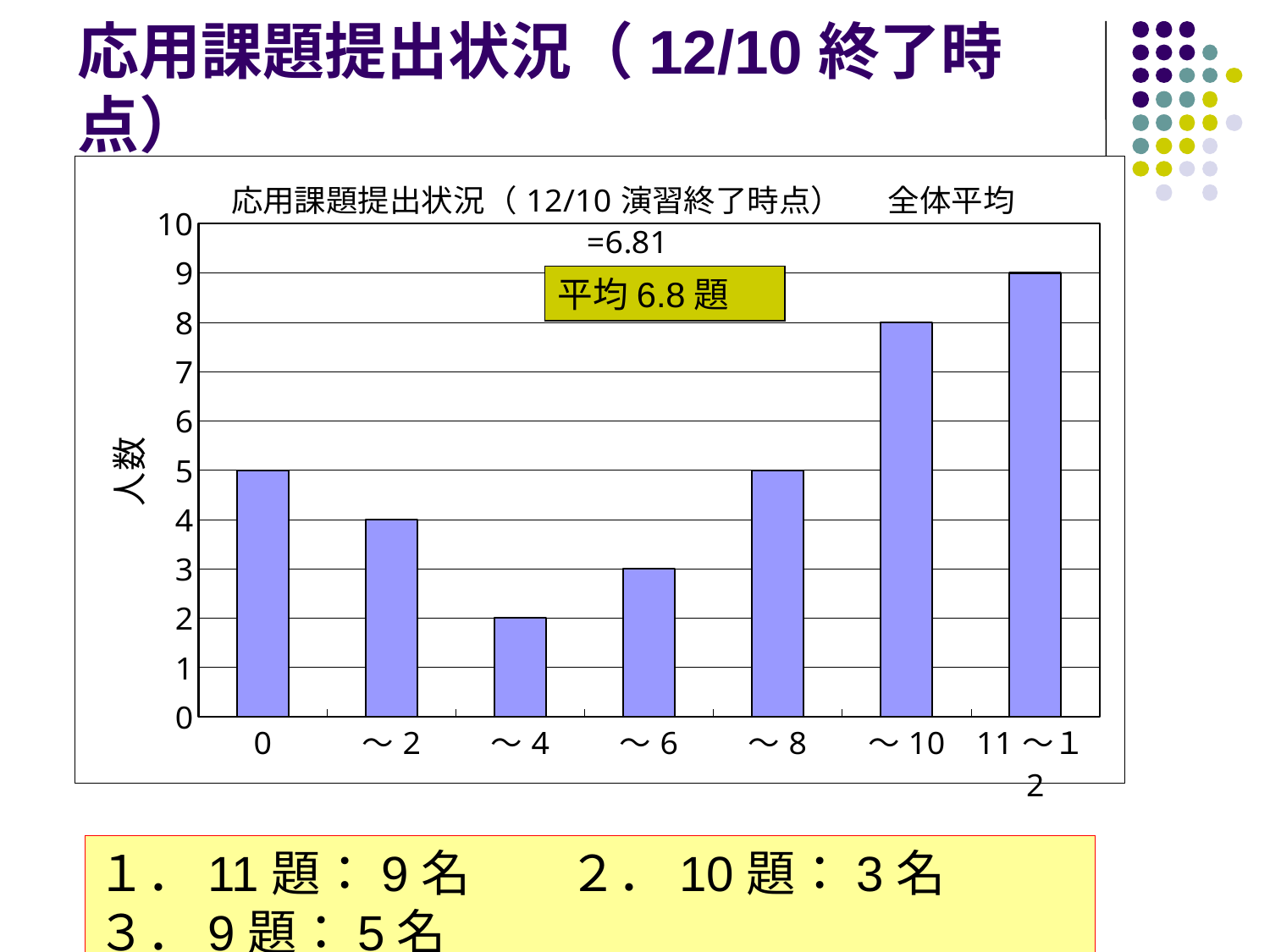
Which category has the lowest value? ～4 What is the difference between the values for 11～12 and ～10? 1 What is the value (人数) for the category 11～12? 9 What is the label of the y axis? 人数 What is the value (人数) for the category ～4? 2 How many categories are shown on the x axis of the chart? 7 What overall average (全体平均) is stated in the chart title? 6.81 Which category has the highest value? 11～12 What is the value (人数) for the category 0? 5 What kind of chart is shown on the slide? bar chart Which is larger, the value for ～2 or the value for ～6? ～2 What is the value (人数) for the category ～10? 8